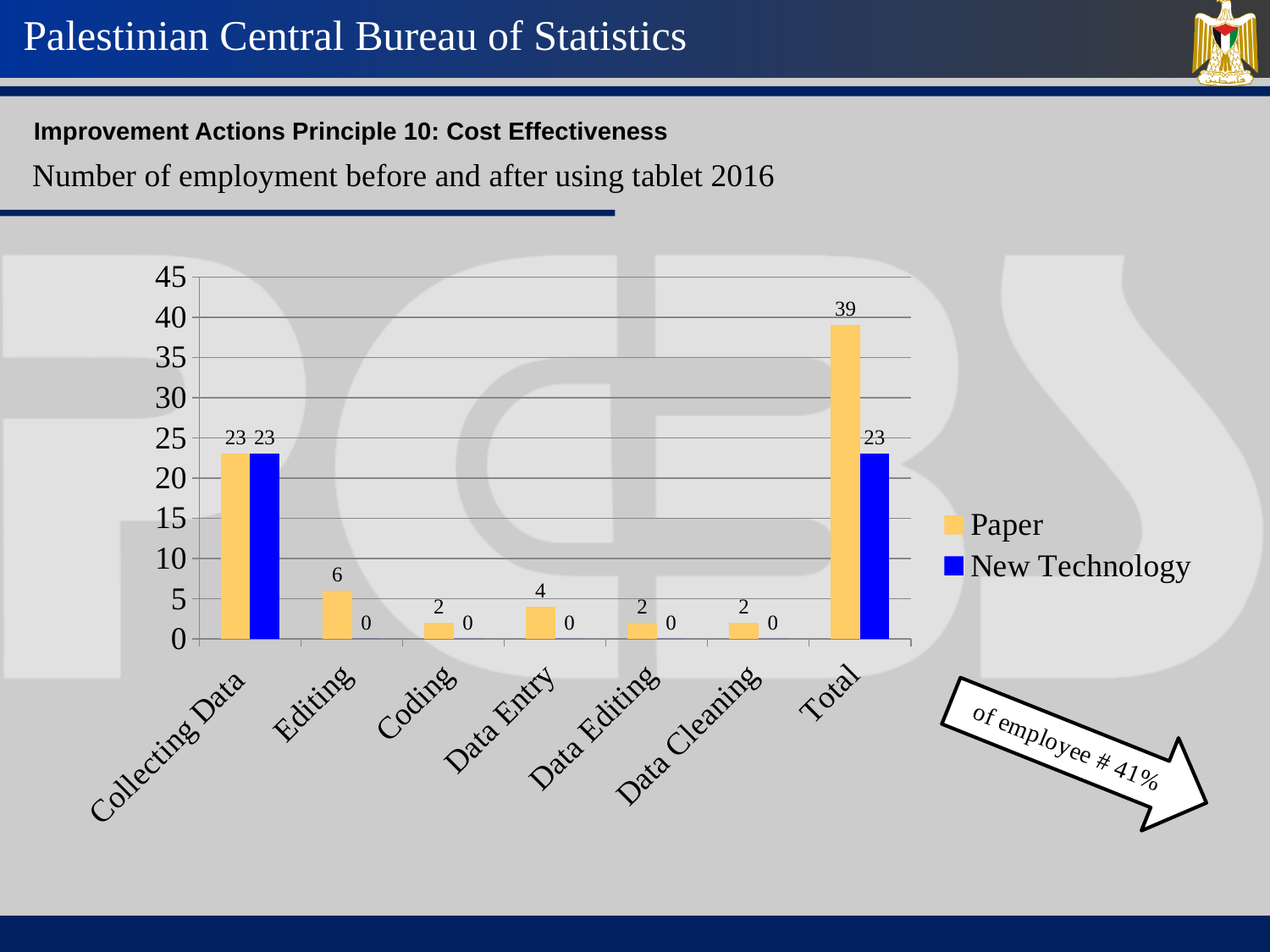
Excluding Total, which category has the lowest Paper value? Coding, Data Editing and Data Cleaning (all 2) How many categories are shown on the x axis? 7 What kind of chart is shown on the slide? bar chart What is the difference between the Paper and New Technology values for Total? 16 Which is larger, the Paper value for Editing or the Paper value for Data Entry? Editing What is the Paper value for Editing? 6 What is the New Technology value for Total? 23 Which category has the highest Paper value? Total What is the Paper value for Data Entry? 4 Is the Paper value for Total greater or less than 35? greater How many series does the legend list? 2 What is the New Technology value for Coding? 0